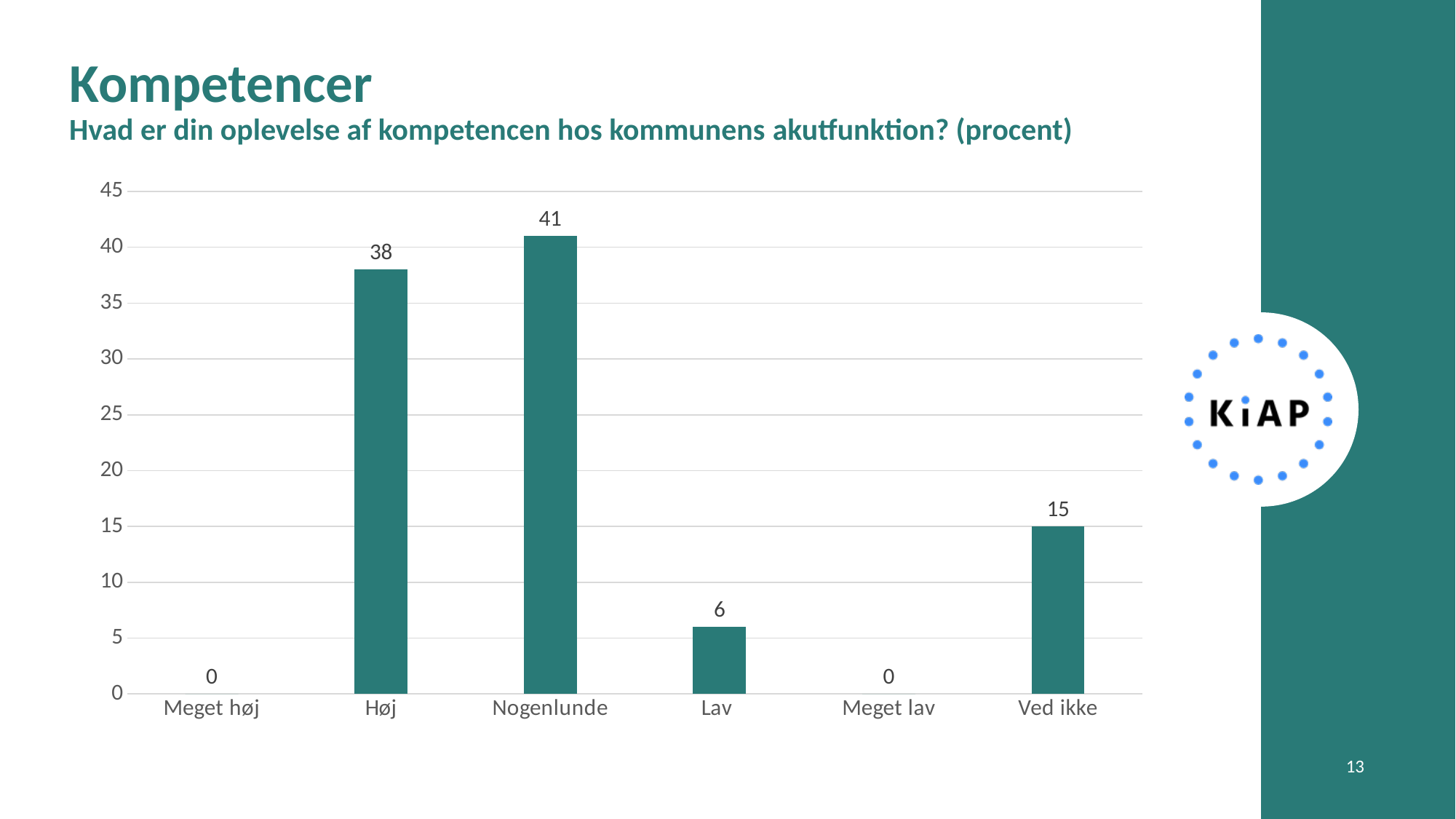
What is the value for Ved ikke? 15 What is the value for Høj? 38 What is the value for Nogenlunde? 41 What is the title of the slide? Kompetencer What is the value for Lav? 6 How many categories are shown on the x axis? 6 Which is larger, the value for Ved ikke or the value for Lav? Ved ikke How many categories have a value of 0? 2 Is the value for Høj greater or less than 35? greater What kind of chart is shown on the slide? bar chart What is the difference between the values for Nogenlunde and Høj? 3 Which category has the highest value? Nogenlunde